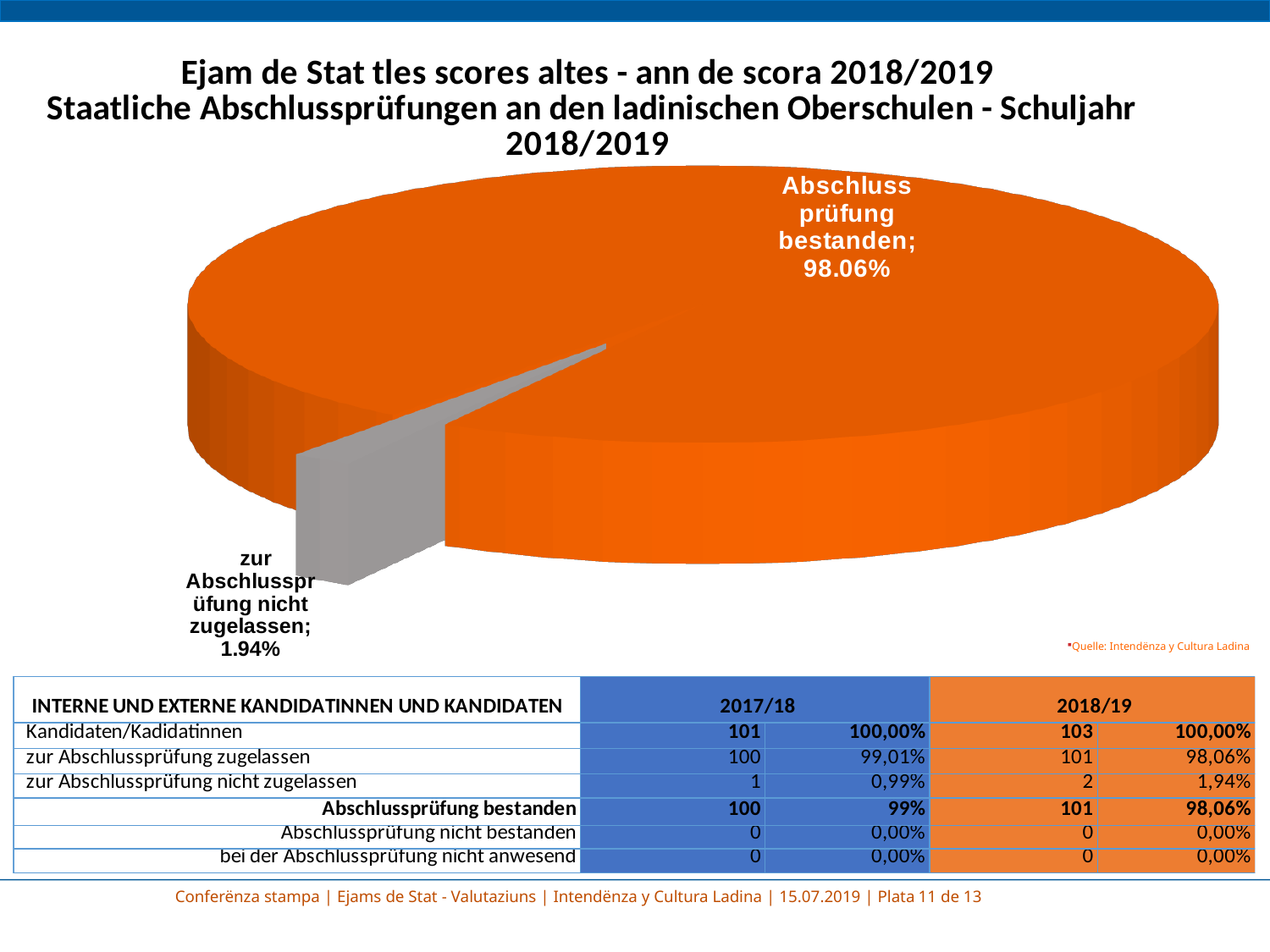
Is the share for "Abschlussprüfung bestanden" greater or less than 90%? greater Which slice of the pie chart is the largest? Abschlussprüfung bestanden What is the difference in percentage points between the "Abschlussprüfung bestanden" slice and the "zur Abschlussprüfung nicht zugelassen" slice? 96.12 percentage points What share of the pie is labelled "Abschlussprüfung bestanden"? 98.06% How many slices does the pie chart have? 2 What colour is the "Abschlussprüfung bestanden" slice of the pie chart? Orange Which slice of the pie chart is the smallest? zur Abschlussprüfung nicht zugelassen What colour is the "zur Abschlussprüfung nicht zugelassen" slice of the pie chart? Grey What share of the pie is labelled "zur Abschlussprüfung nicht zugelassen"? 1.94% Which is larger in the pie chart: "Abschlussprüfung bestanden" or "zur Abschlussprüfung nicht zugelassen"? Abschlussprüfung bestanden What kind of chart is shown on the slide? Pie chart Is the share for "zur Abschlussprüfung nicht zugelassen" greater or less than 10%? less